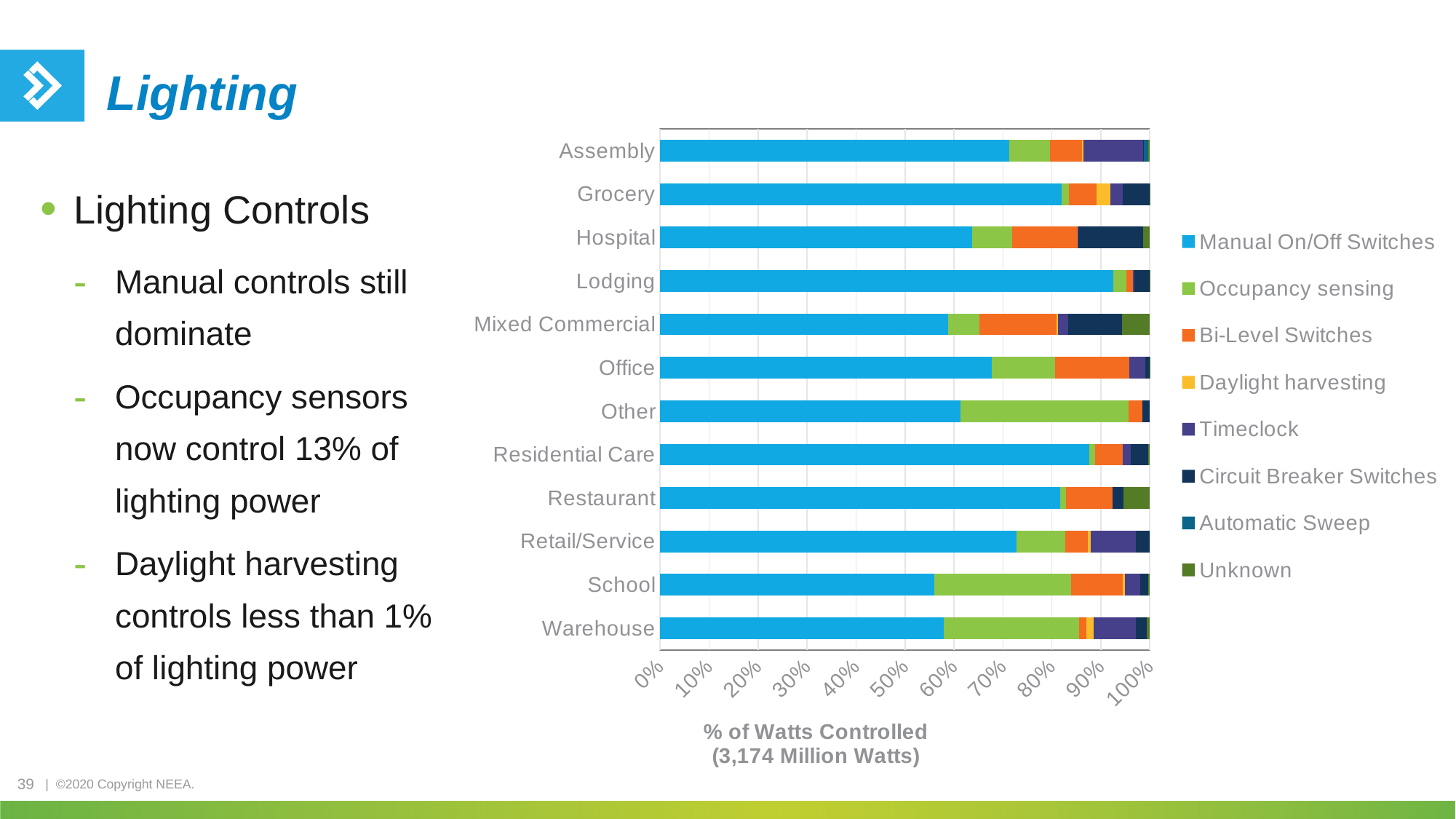
What is the title of the chart's horizontal axis? % of Watts Controlled (3,174 Million Watts) Which has a larger Occupancy sensing share, School or Grocery? School Which building type has the largest share of watts controlled by Occupancy sensing? Other How many series does the chart legend list? 8 Is the Manual On/Off Switches share for Grocery greater or less than 80%? greater Is the Manual On/Off Switches share for Lodging greater or less than 90%? greater Which building type has the largest share of watts controlled by Manual On/Off Switches? Lodging How many building-type categories are plotted on the chart? 12 What kind of chart is shown on the slide? Stacked bar chart Is the Manual On/Off Switches share for School greater or less than 60%? less Which has a larger Manual On/Off Switches share, Lodging or Hospital? Lodging